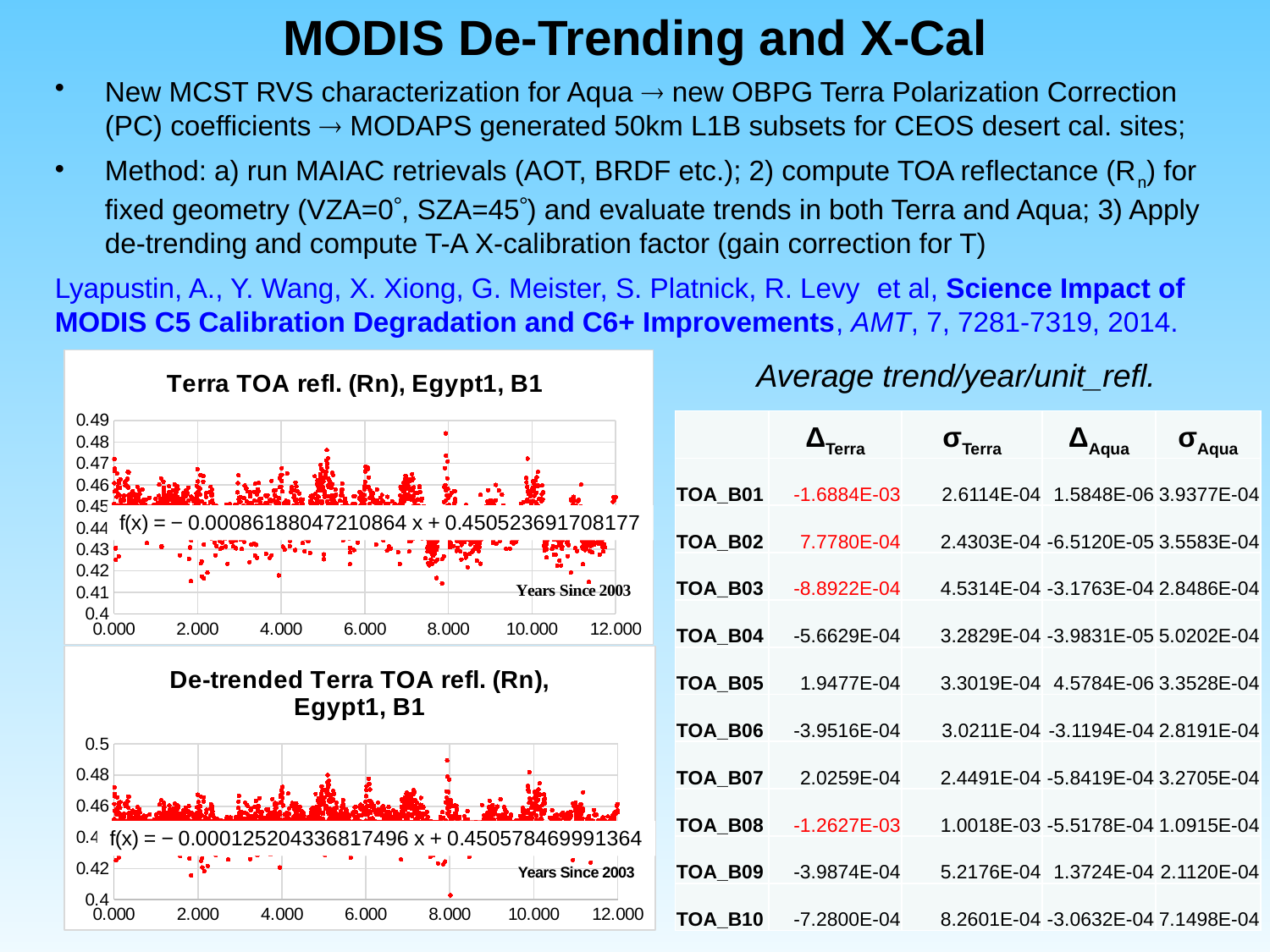
What kind of chart is the top chart titled "Terra TOA refl. (Rn), Egypt1, B1"? scatter chart In the top chart "Terra TOA refl. (Rn), Egypt1, B1", what is the slope of the fitted trend line? − 0.00086188047210864 In the bottom chart "De-trended Terra TOA refl. (Rn), Egypt1, B1", what is the fitted trend line equation printed on the chart? f(x) = − 0.000125204336817496 x + 0.450578469991364 According to the fitted trend line in the top chart "Terra TOA refl. (Rn), Egypt1, B1", do the values rise or fall with years since 2003? fall What is the x-axis label shown on the top chart "Terra TOA refl. (Rn), Egypt1, B1"? Years Since 2003 In the bottom chart "De-trended Terra TOA refl. (Rn), Egypt1, B1", what is the intercept of the fitted trend line? 0.450578469991364 Which chart has the fitted trend line with the steeper (larger magnitude) slope, the top chart "Terra TOA refl. (Rn), Egypt1, B1" or the bottom chart "De-trended Terra TOA refl. (Rn), Egypt1, B1"? Terra TOA refl. (Rn), Egypt1, B1 What is the highest tick value on the y axis of the top chart "Terra TOA refl. (Rn), Egypt1, B1"? 0.49 What kind of chart is the bottom chart titled "De-trended Terra TOA refl. (Rn), Egypt1, B1"? scatter chart What is the highest tick value on the x axis of the bottom chart "De-trended Terra TOA refl. (Rn), Egypt1, B1"? 12.000 In the top chart "Terra TOA refl. (Rn), Egypt1, B1", what is the fitted trend line equation printed on the chart? f(x) = − 0.00086188047210864 x + 0.450523691708177 What is the title of the top chart on the slide? Terra TOA refl. (Rn), Egypt1, B1